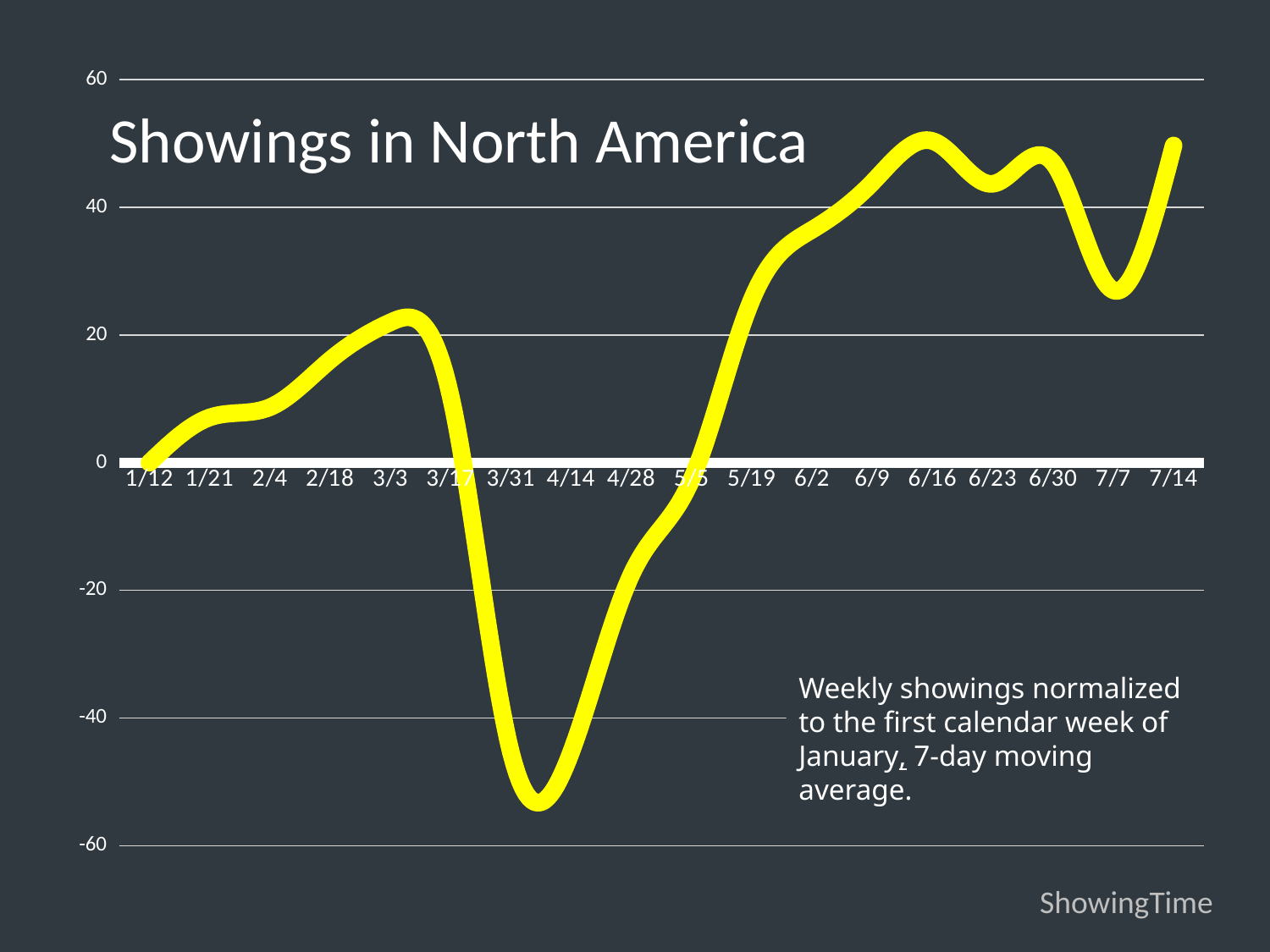
Which is larger, the value for 6/16 or the value for 7/7? 6/16 Is the lowest point of the line above or below -40? below Does the line rise or fall between 1/12 and 3/3? rise What kind of chart is shown on the slide? line chart Is the value for 6/16 greater or less than 40? greater Is the value for 7/7 greater or less than 20? greater How many date labels are shown on the x axis? 18 What colour is the plotted line? yellow What is the title of the chart? Showings in North America Does the line rise or fall between 6/30 and 7/7? fall